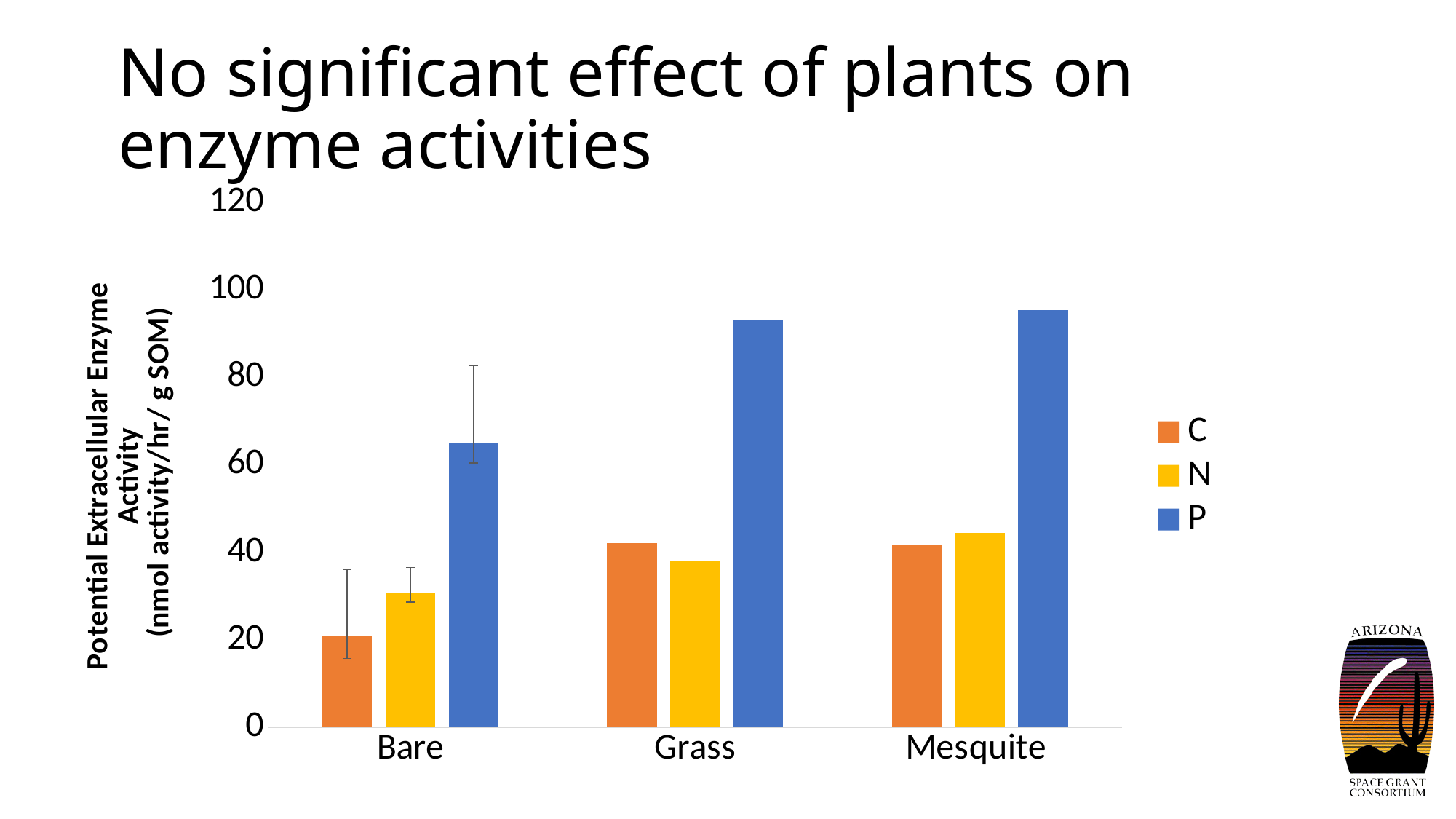
Which category has the lowest value for series C? Bare Is the value for P in the Bare category greater or less than 60? greater Which series has the highest value in the Bare category? P What is the y-axis label of the chart? Potential Extracellular Enzyme Activity (nmol activity/hr/ g SOM) Is the value for P in the Grass category greater or less than 80? greater Which category has the lowest value for series P? Bare Which is larger: the value for P in Bare or the value for P in Grass? P in Grass What are the series names listed in the legend? C, N, P How many categories are shown on the x axis? 3 What kind of chart is shown on the slide? bar chart Is the value for C in the Bare category greater or less than 40? less How many series does the legend list? 3